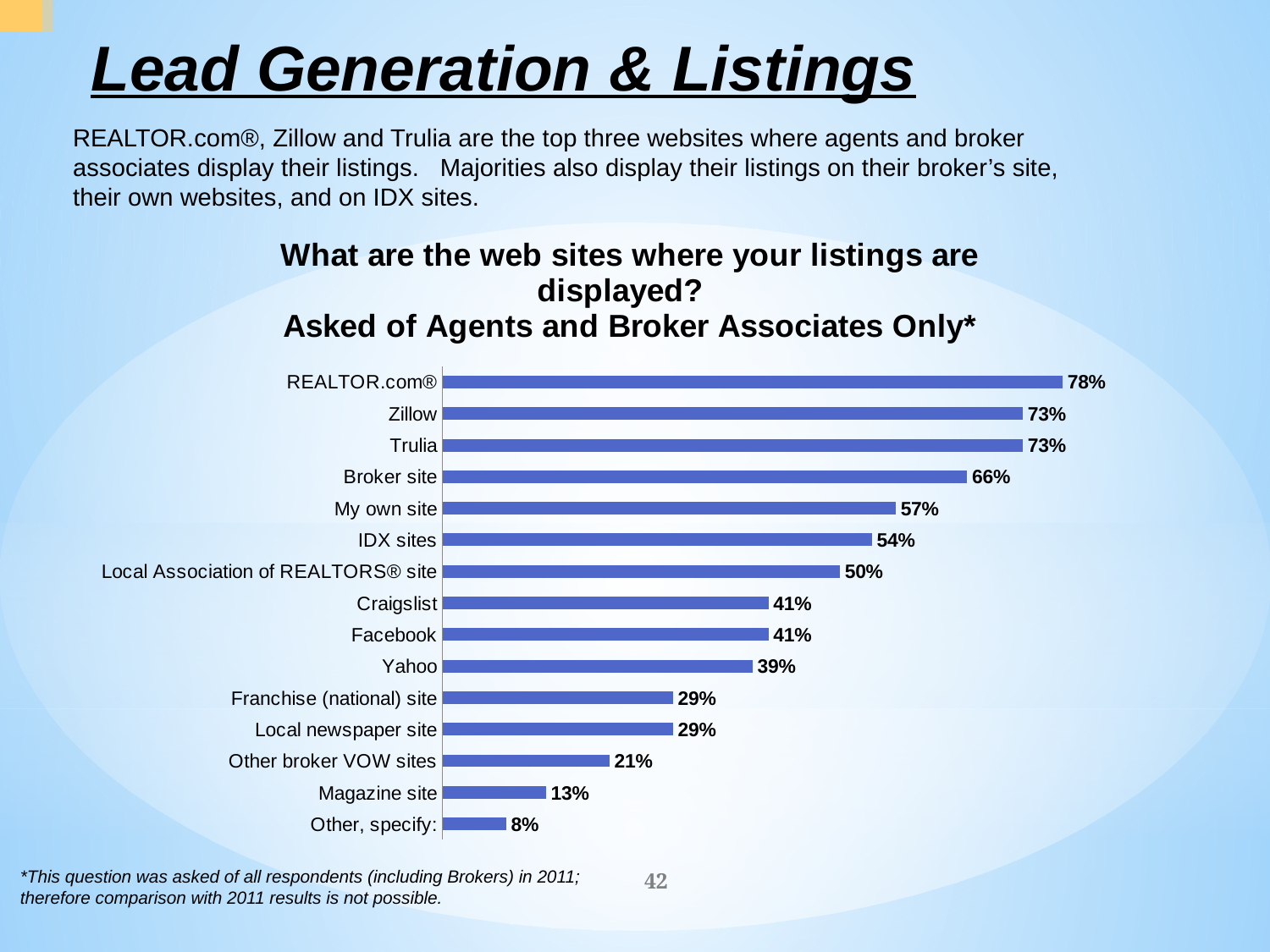
Which two websites both show a value of 73%? Zillow and Trulia What is the difference between the values for Craigslist and Other broker VOW sites? 20% What is the value shown for IDX sites? 54% Which website has the highest percentage in the chart? REALTOR.com® Which category has the lowest percentage in the chart? Other, specify: How many categories are shown in the chart? 15 What is the title of the chart? What are the web sites where your listings are displayed? Asked of Agents and Broker Associates Only* What is the difference between the values for REALTOR.com® and Broker site? 12% What kind of chart is shown on the slide? Bar chart What percentage of agents and broker associates display their listings on REALTOR.com®? 78% What is the value shown for Magazine site? 13% Which is larger, the value for Yahoo or the value for Franchise (national) site? Yahoo